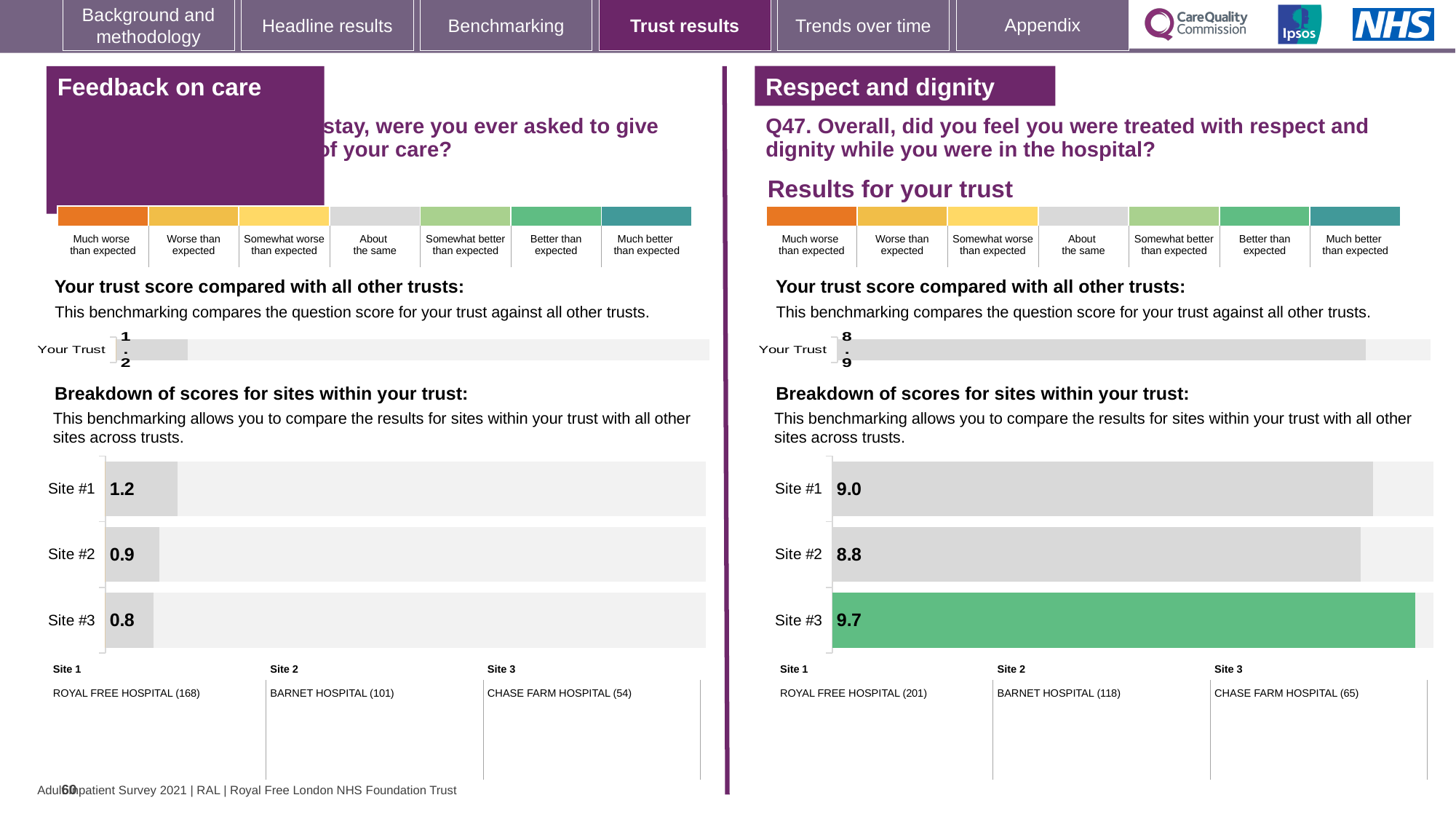
In the 'Feedback on care' site breakdown chart, what is the score for Site #3? 0.8 In the 'Feedback on care' site breakdown chart, which site has the lowest score? Site #3 In the 'Feedback on care' site breakdown chart, what is the score for Site #1? 1.2 In the 'Respect and dignity' site breakdown chart, which site's bar is coloured green? Site #3 In the 'Respect and dignity' site breakdown chart, which site has the highest score? Site #3 In the 'Feedback on care' site breakdown chart, what is the difference between the scores for Site #1 and Site #2? 0.3 What type of chart is used for the 'Respect and dignity' site breakdown? Bar chart In the 'Respect and dignity' site breakdown chart, which is larger: the score for Site #1 or Site #2? Site #1 In the 'Respect and dignity' section, what is the 'Your Trust' score shown in the trust comparison chart? 8.9 In the 'Respect and dignity' site breakdown chart, what is the score for Site #2? 8.8 How many sites are shown in the 'Feedback on care' site breakdown chart? 3 In the 'Respect and dignity' site breakdown chart, what is the difference between the scores for Site #3 and Site #2? 0.9